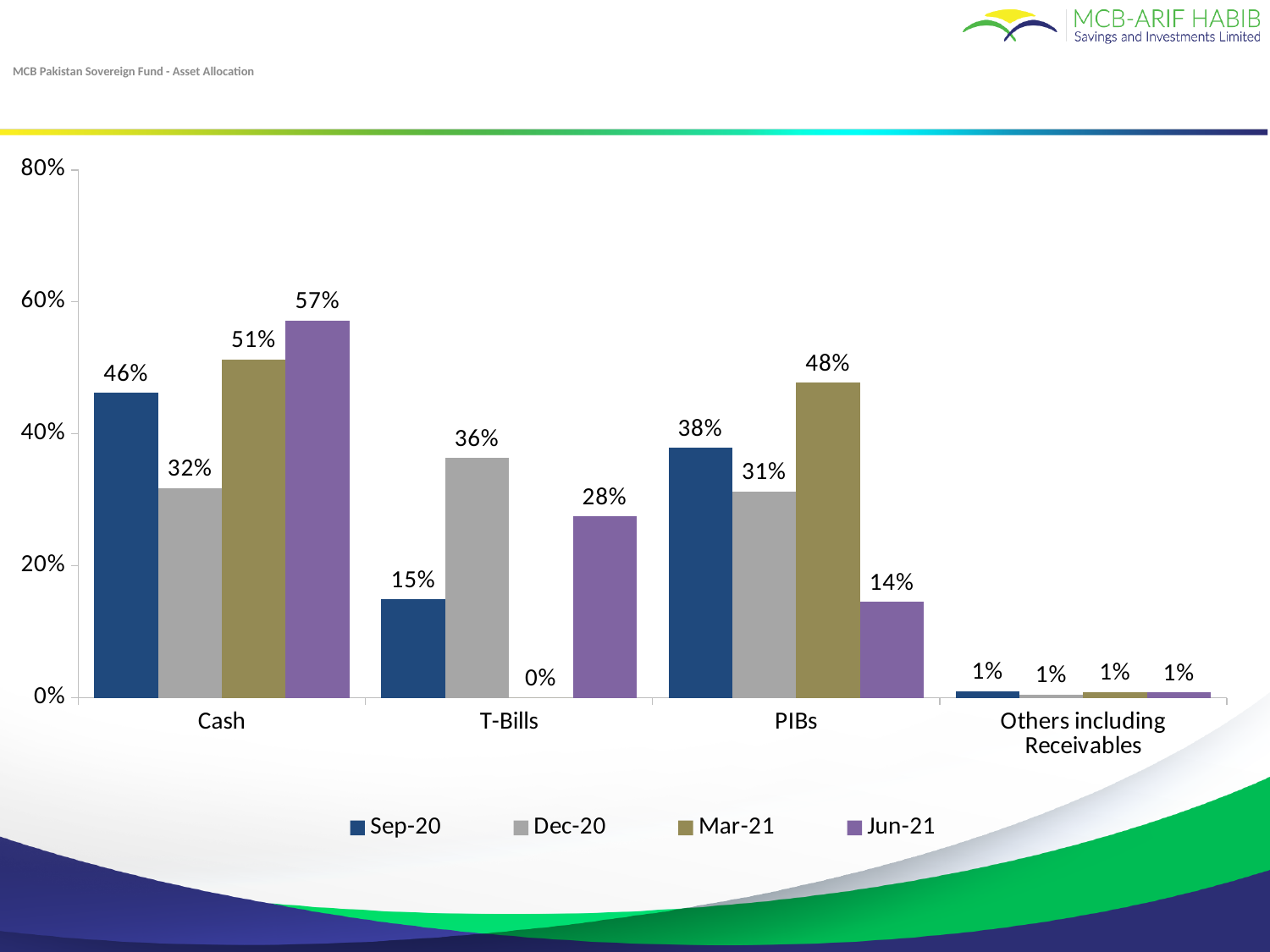
Which category has the lowest allocation in Jun-21? Others including Receivables What is the T-Bills allocation for Dec-20? 36% What is the PIBs allocation for Mar-21? 48% Which is larger for PIBs: the Sep-20 value or the Dec-20 value? Sep-20 How many categories are shown on the x axis? 4 Which category has the highest allocation in Sep-20? Cash How many series does the legend list? 4 What is the T-Bills allocation for Mar-21? 0% Does the Cash allocation rise or fall from Dec-20 to Jun-21? Rise What is the Cash allocation for Jun-21? 57% What kind of chart is shown on the slide? Bar chart What is the difference between the Cash allocation in Jun-21 and in Sep-20? 11%